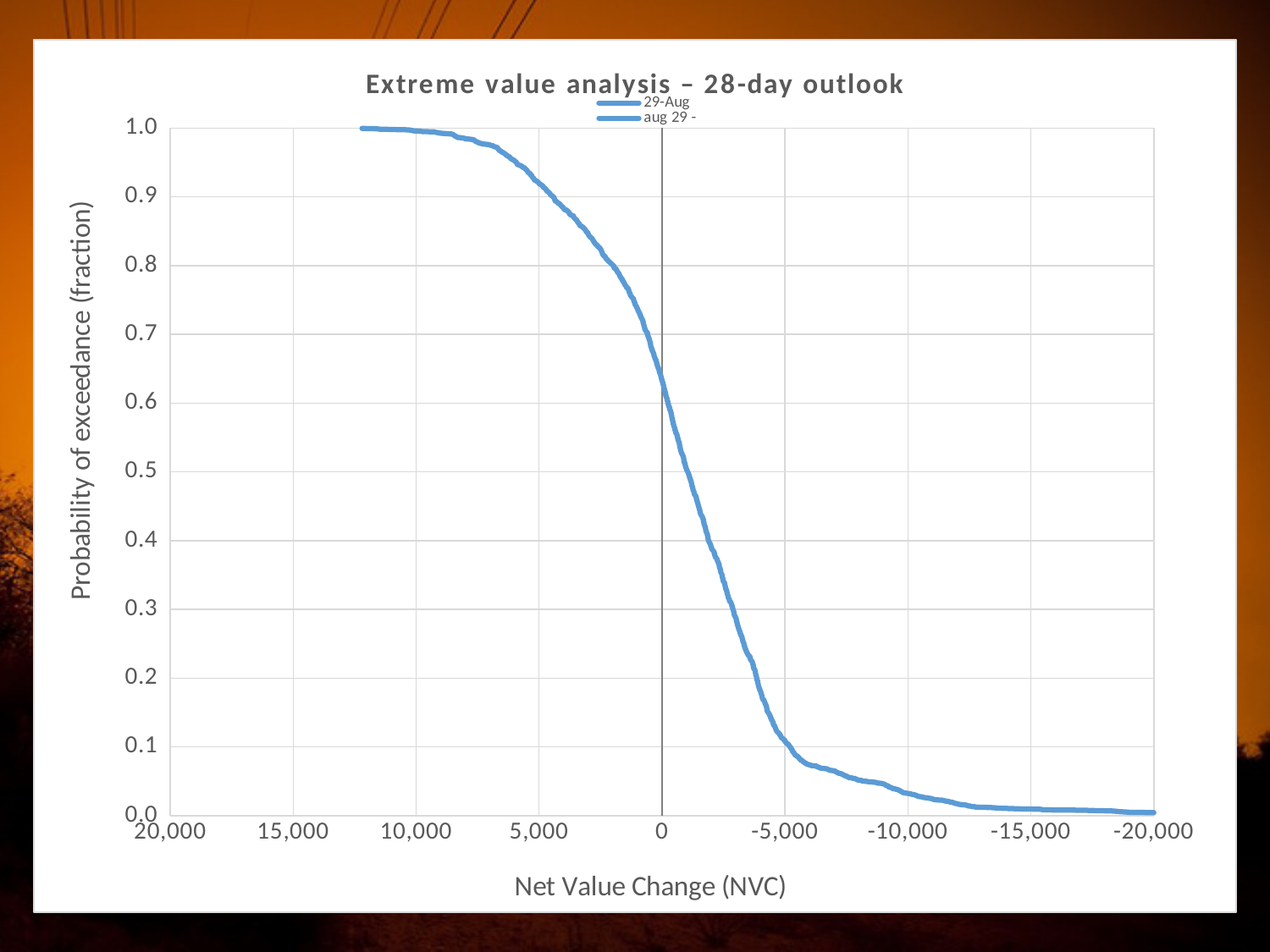
What is the title of the chart? Extreme value analysis – 28-day outlook Which is larger: the probability of exceedance at a Net Value Change of 5,000 or at -5,000? 5,000 What kind of chart is shown on the slide? line chart How many entries does the legend list? 2 What is the label of the vertical axis? Probability of exceedance (fraction) Is the probability of exceedance at a Net Value Change of 5,000 greater or less than 0.9? greater Is the probability of exceedance at a Net Value Change of 10,000 greater or less than 0.9? greater Is the probability of exceedance at a Net Value Change of -10,000 greater or less than 0.1? less Does the probability of exceedance rise or fall moving from left to right along the x axis? fall